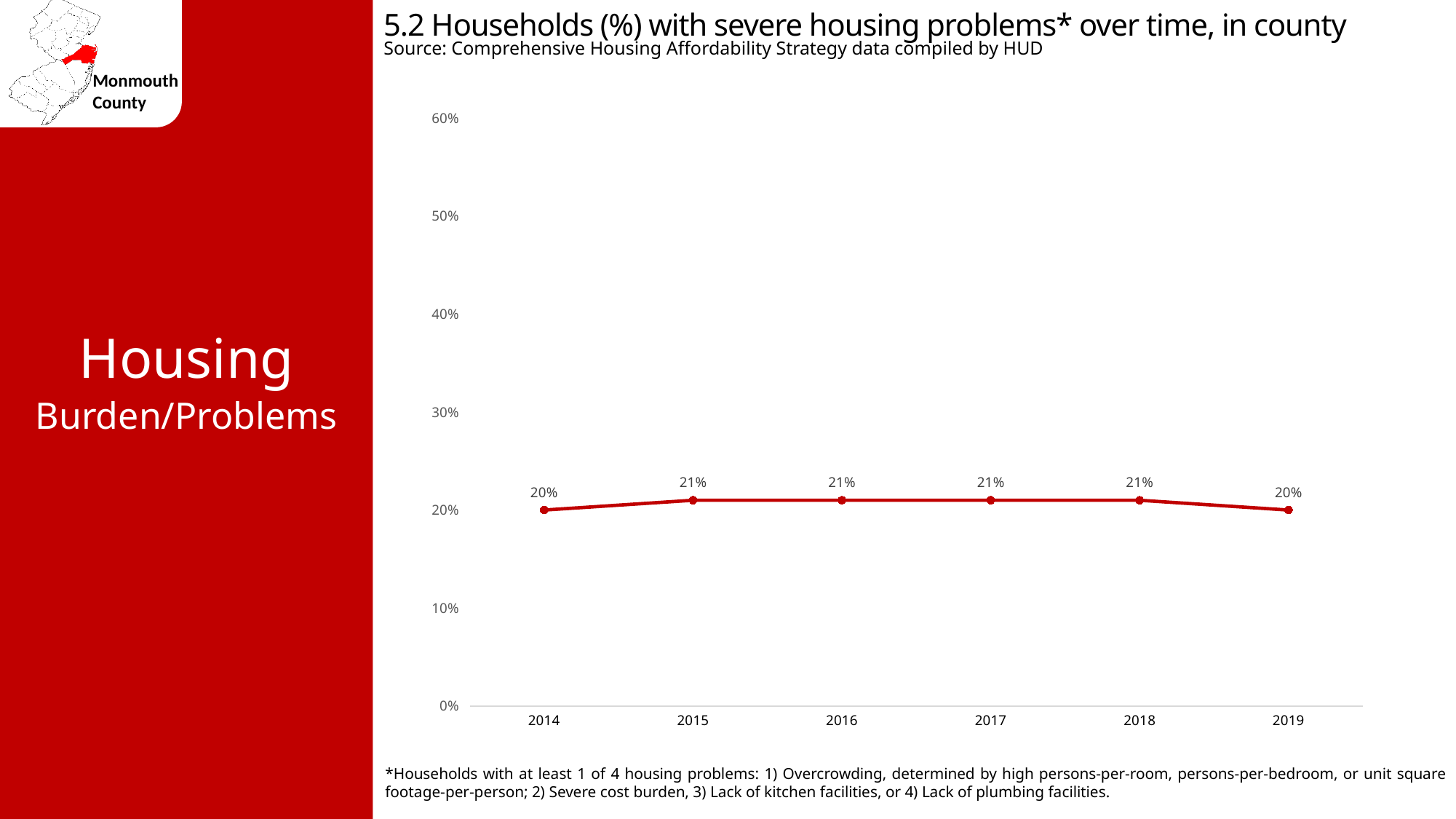
Is the value for 2018 greater or less than 10%? greater What is the value shown for 2015? 21% What is the difference between the values for 2015 and 2014? 1% What kind of chart is shown on the slide? line chart How many years are plotted on the chart? 6 Is the value for 2016 greater or less than 30%? less What percentage of households had severe housing problems in 2019? 20% What is the source of the data cited on the slide? Comprehensive Housing Affordability Strategy data compiled by HUD What percentage of households had severe housing problems in 2014? 20% What is the title of the chart? 5.2 Households (%) with severe housing problems* over time, in county What is the value shown for 2017? 21% Which is larger, the value for 2018 or the value for 2019? 2018